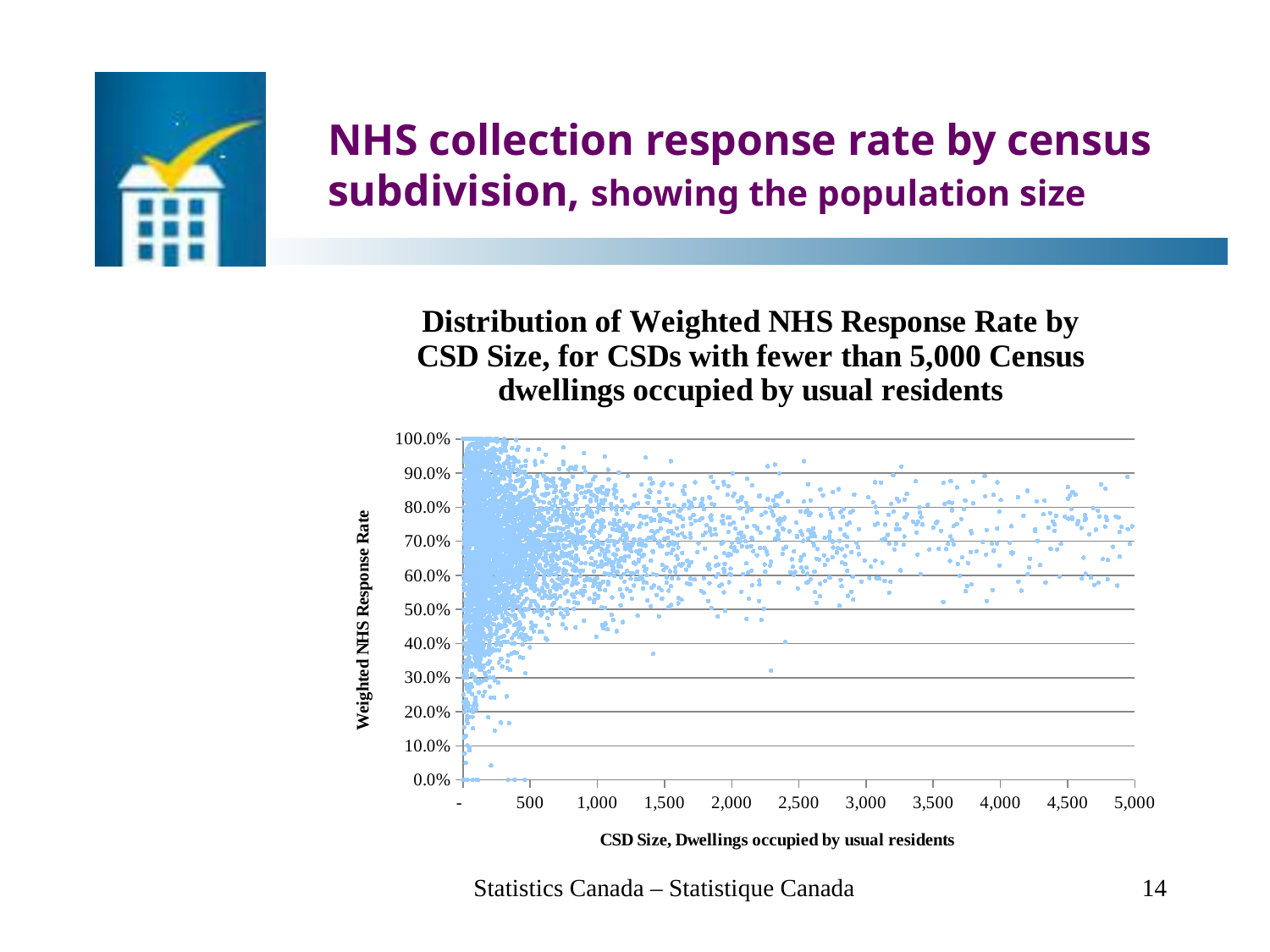
What is the label of the x axis of the chart? CSD Size, Dwellings occupied by usual residents Are most of the plotted points above or below the 30.0% line on the y axis? above Are the plotted points more densely clustered at CSD sizes below 500 or above 4,000? below 500 What is the title of the chart? Distribution of Weighted NHS Response Rate by CSD Size, for CSDs with fewer than 5,000 Census dwellings occupied by usual residents What kind of chart is shown on the slide? scatter chart